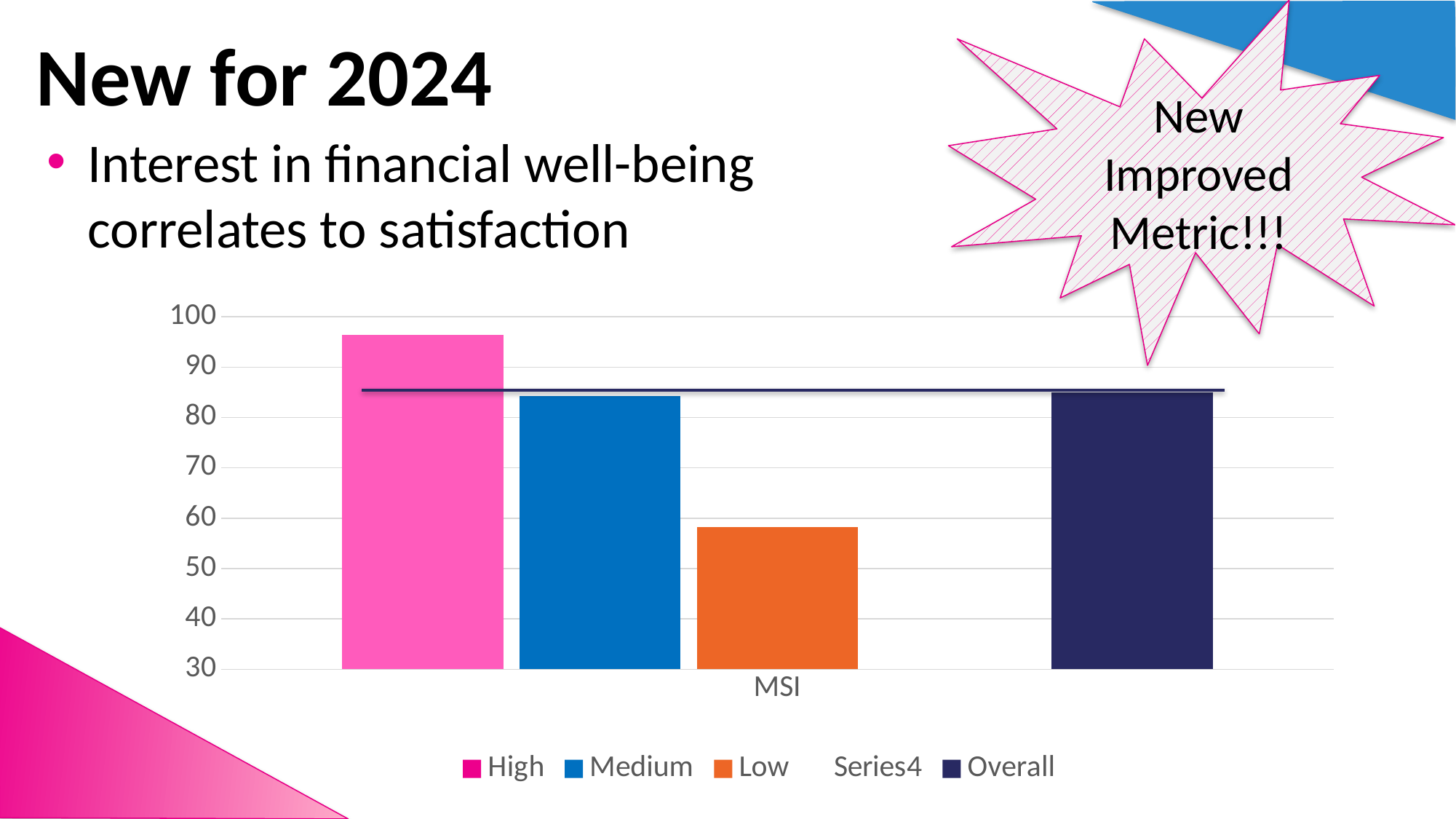
Which series has the highest bar in the chart? High Which series has the lowest bar in the chart? Low What kind of chart is shown on the slide? bar chart Which is larger, the bar for Medium or the bar for Low? Medium Is the value for Low greater or less than 60? less How many categories are shown on the x axis of the chart? 1 How many series does the chart legend list? 5 Is the value for Medium greater or less than 80? greater Is the value for High greater or less than 90? greater What colour is the bar for the High series? pink What is the category label shown on the x axis of the chart? MSI Which is larger, the bar for High or the bar for Low? High